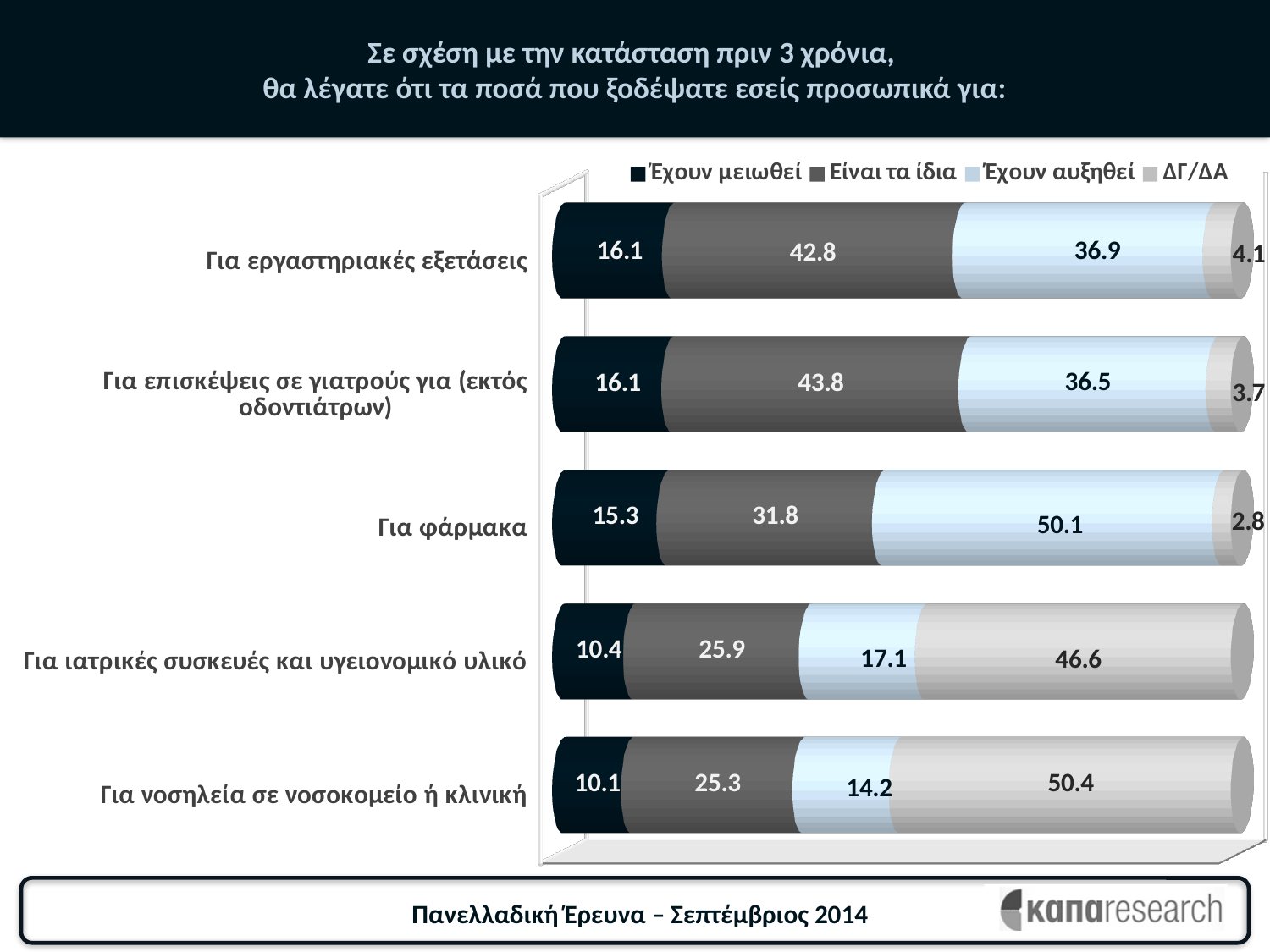
What is the difference between the 'Έχουν αυξηθεί' values for 'Για φάρμακα' and 'Για εργαστηριακές εξετάσεις'? 13.2 Which category has the highest 'Έχουν αυξηθεί' value? Για φάρμακα What is the value of 'Είναι τα ίδια' for 'Για επισκέψεις σε γιατρούς για (εκτός οδοντιάτρων)'? 43.8 Which legend entry is represented by the darkest segment of each bar? Έχουν μειωθεί How many series does the legend list? 4 Which is larger: the 'Είναι τα ίδια' value for 'Για εργαστηριακές εξετάσεις' or for 'Για φάρμακα'? Για εργαστηριακές εξετάσεις What is the value of 'Έχουν αυξηθεί' for 'Για φάρμακα'? 50.1 What is the 'ΔΓ/ΔΑ' value for 'Για ιατρικές συσκευές και υγειονομικό υλικό'? 46.6 What is the total of the stacked bar for 'Για νοσηλεία σε νοσοκομείο ή κλινική'? 100.0 Which category has the lowest 'Έχουν μειωθεί' value? Για νοσηλεία σε νοσοκομείο ή κλινική What kind of chart is shown on the slide? Stacked bar chart How many categories are shown in the chart? 5